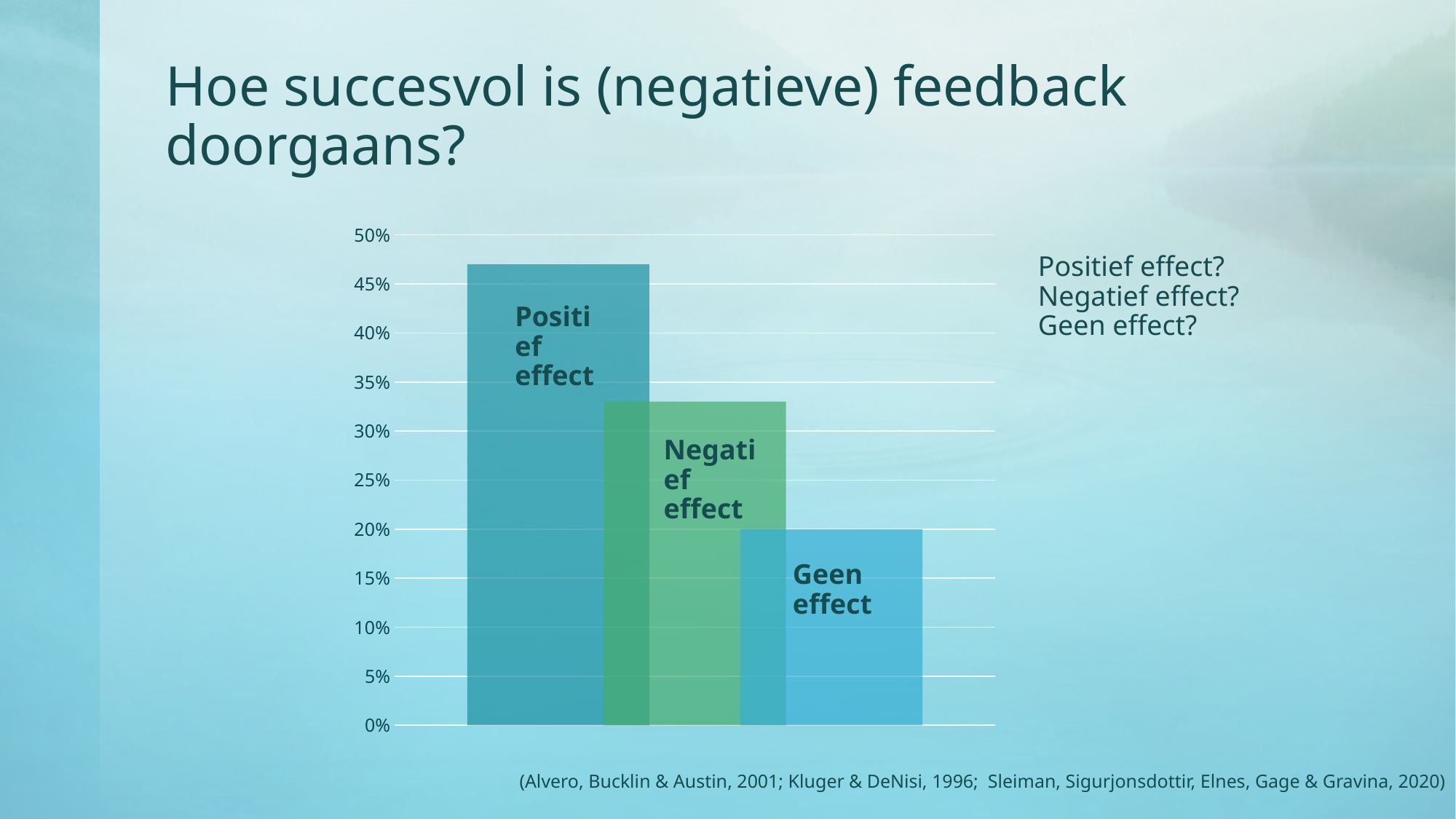
Is the value for Negatief effect greater or less than 30%? greater Which category has the lowest value? Geen effect Is the value for Geen effect greater or less than 25%? less Which is larger, the value for Positief effect or the value for Negatief effect? Positief effect Do the bar values rise or fall from left to right across the chart? fall How many bars (categories) does the chart show? 3 What is the title of the slide containing the chart? Hoe succesvol is (negatieve) feedback doorgaans? Is the value for Positief effect greater or less than 45%? greater What kind of chart is shown on the slide? bar chart Which category has the highest value? Positief effect Which is larger, the value for Negatief effect or the value for Geen effect? Negatief effect